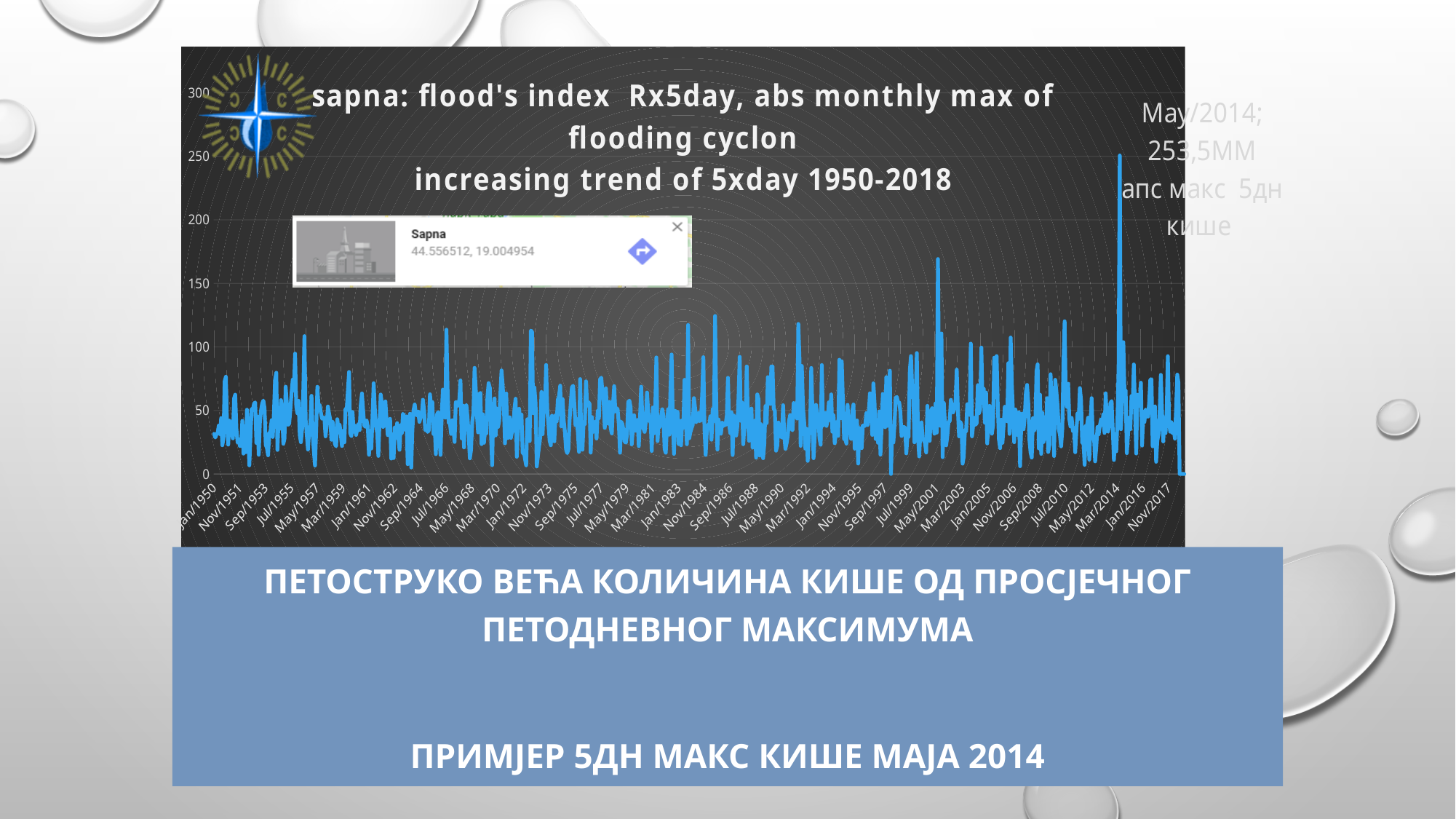
In which month does the Rx5day series reach its highest value? May/2014 What is the absolute maximum 5-day rainfall value annotated on the chart for May 2014? 253,5MM Is the peak value in May/2014 greater or less than 300? less What is the first year label shown on the x axis? Jan/1950 Which station is the flood's index chart about? Sapna How many data series are plotted on the chart? 1 What is the highest value shown on the y axis? 300 What kind of chart is shown on the slide? line chart Is the peak value in May/2014 greater or less than 200? greater According to the chart title, what is the trend of the 5xday index over 1950-2018? increasing